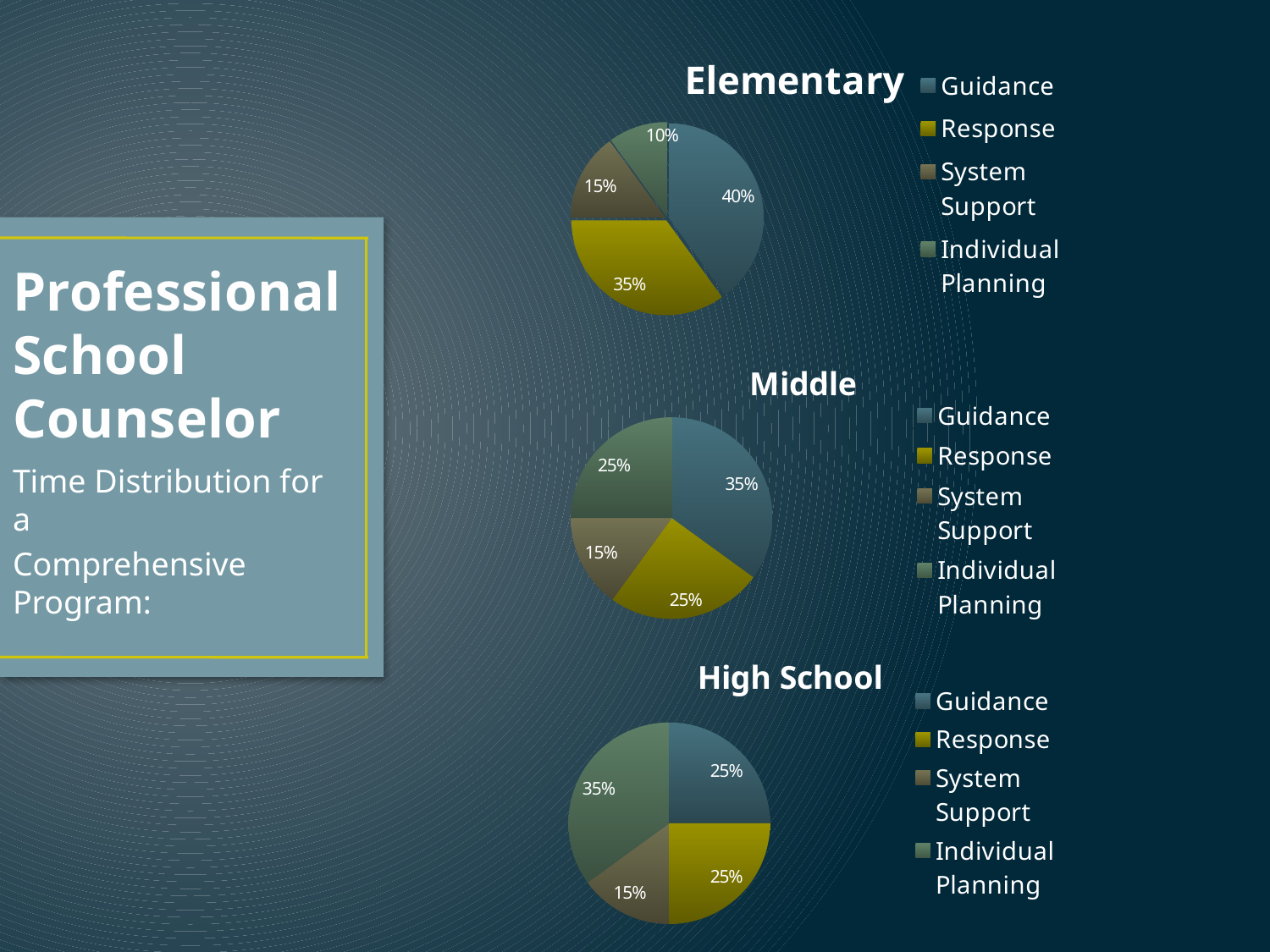
What type of chart is the Middle chart? Pie chart In the Elementary chart, what share of time is Individual Planning? 10% In the Elementary chart, which category has the smallest share? Individual Planning In the Middle chart, what is the difference between the Guidance share and the Response share? 10% In the High School chart, which is larger, Guidance or System Support? Guidance In the Elementary chart, what share of time is Guidance? 40% In the Middle chart, what share of time is Guidance? 35% How many categories does the legend of the High School chart list? 4 In the High School chart, what share of time is Individual Planning? 35% In the Elementary chart, which category has the largest share? Guidance In the High School chart, which category has the largest share? Individual Planning In the Middle chart, what share of time is System Support? 15%